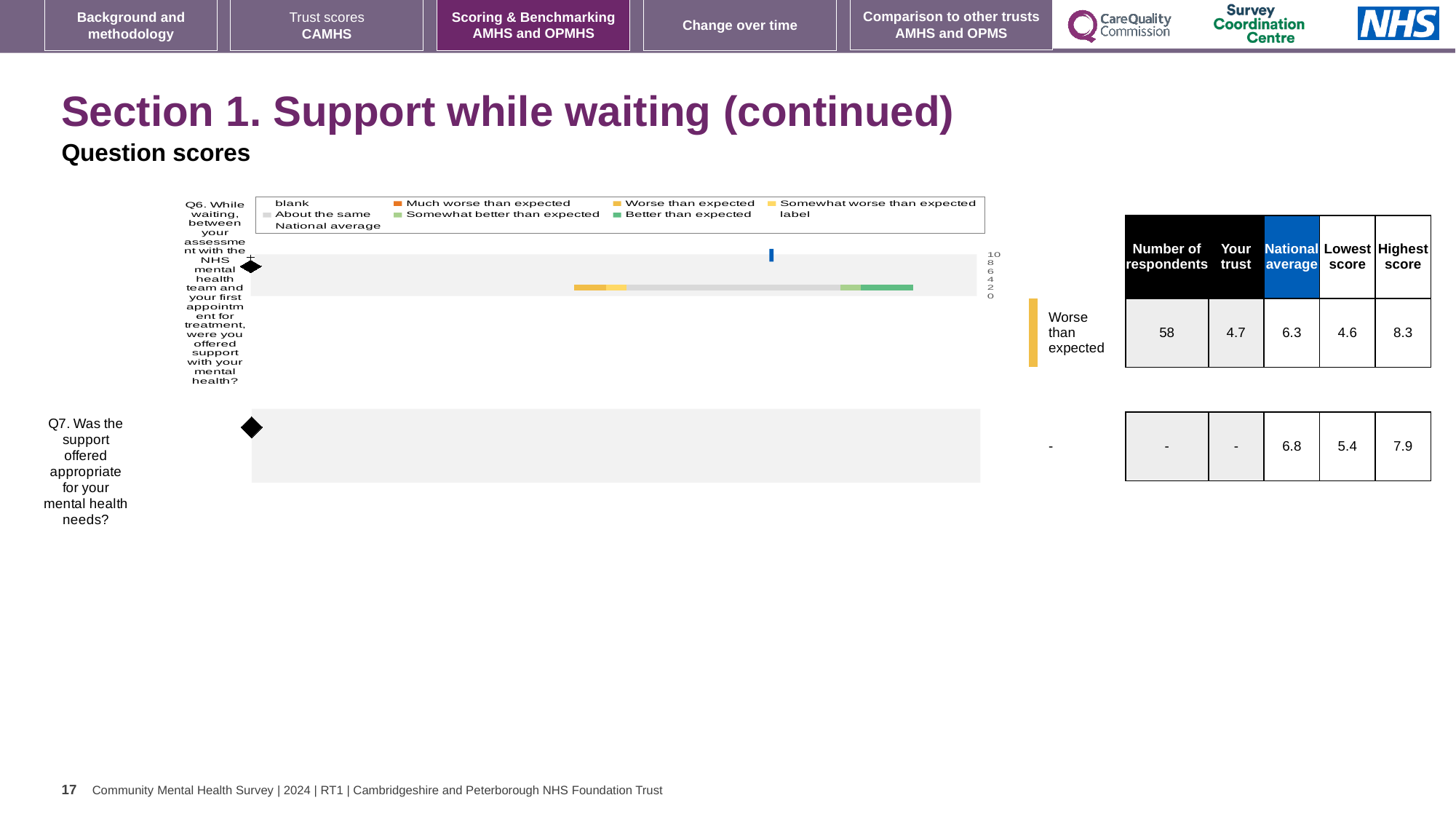
How many respondents answered Q6? 58 What kind of chart is used to show the Q6 benchmarking result? bar chart According to the table beside the chart, what is the trust's score for Q6 (support with mental health while waiting)? 4.7 What is the national average score for Q7 (was the support offered appropriate)? 6.8 Which benchmarking category is the trust's Q6 score placed in? Worse than expected For Q6, which is larger: the trust's score or the national average? National average What is the national average score for Q6 shown in the table? 6.3 For Q7, what is the difference between the highest score (7.9) and the lowest score (5.4)? 2.5 In the chart legend, what colour represents 'Much worse than expected'? Orange What is the highest score for Q6 shown in the table? 8.3 For Q6, what is the difference between the national average (6.3) and the trust's score (4.7)? 1.6 What is the lowest score for Q6 shown in the table? 4.6